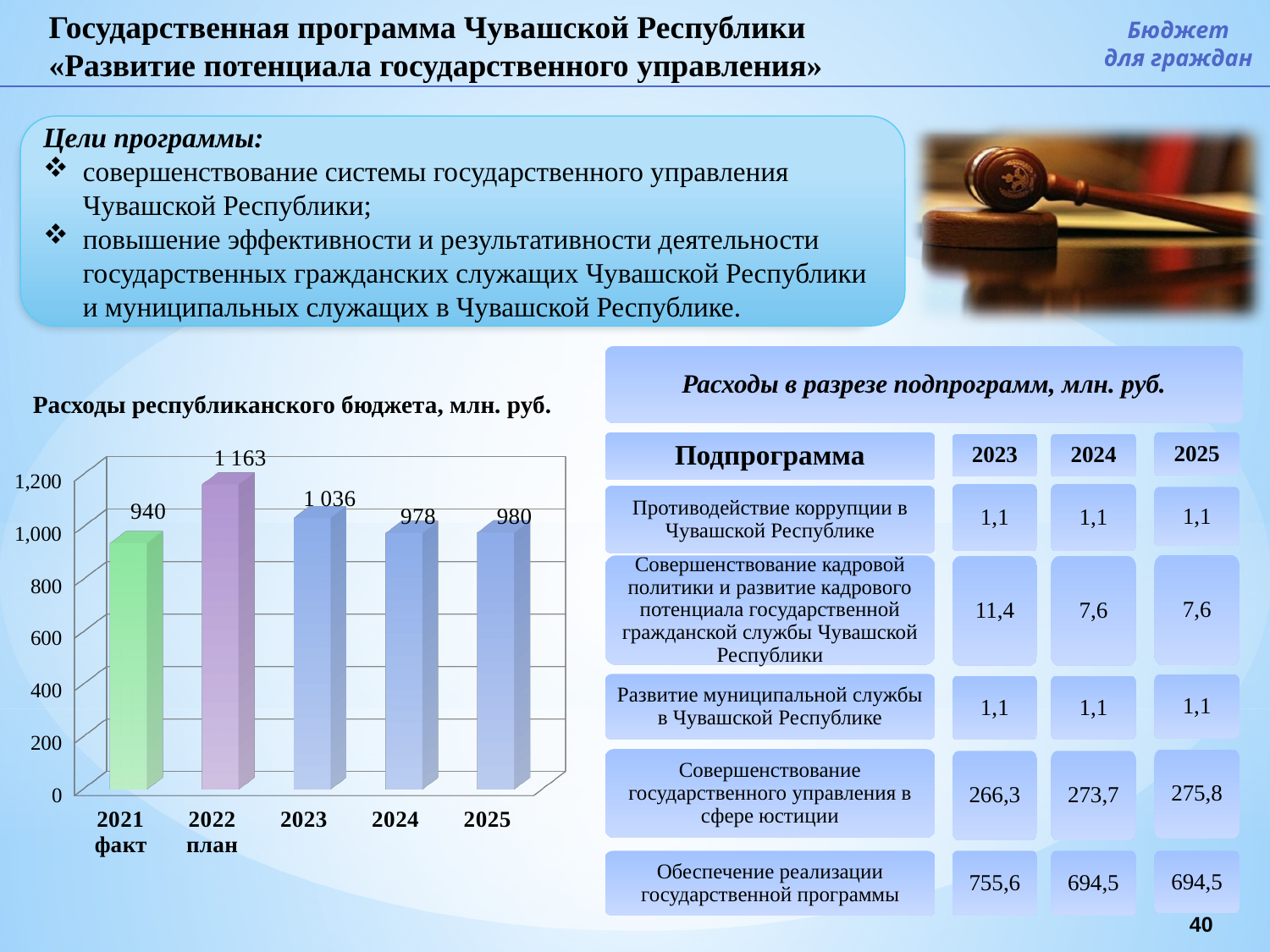
How many bars are shown in the chart 'Расходы республиканского бюджета, млн. руб.'? 5 Which year has the lowest value in the chart 'Расходы республиканского бюджета, млн. руб.'? 2021 факт What type of chart is 'Расходы республиканского бюджета, млн. руб.'? bar chart What is the value for 2021 факт in the chart 'Расходы республиканского бюджета, млн. руб.'? 940 What is the value for 2023 in the chart 'Расходы республиканского бюджета, млн. руб.'? 1 036 In the chart 'Расходы республиканского бюджета, млн. руб.', which is larger: the value for 2023 or the value for 2025? 2023 Is the value for 2024 in the chart 'Расходы республиканского бюджета, млн. руб.' greater or less than 1,000? less Which year has the highest value in the chart 'Расходы республиканского бюджета, млн. руб.'? 2022 план What is the difference between the values for 2022 план and 2021 факт in the chart 'Расходы республиканского бюджета, млн. руб.'? 223 What is the value for 2022 план in the chart 'Расходы республиканского бюджета, млн. руб.'? 1 163 What is the value for 2025 in the chart 'Расходы республиканского бюджета, млн. руб.'? 980 What is the difference between the values for 2023 and 2024 in the chart 'Расходы республиканского бюджета, млн. руб.'? 58